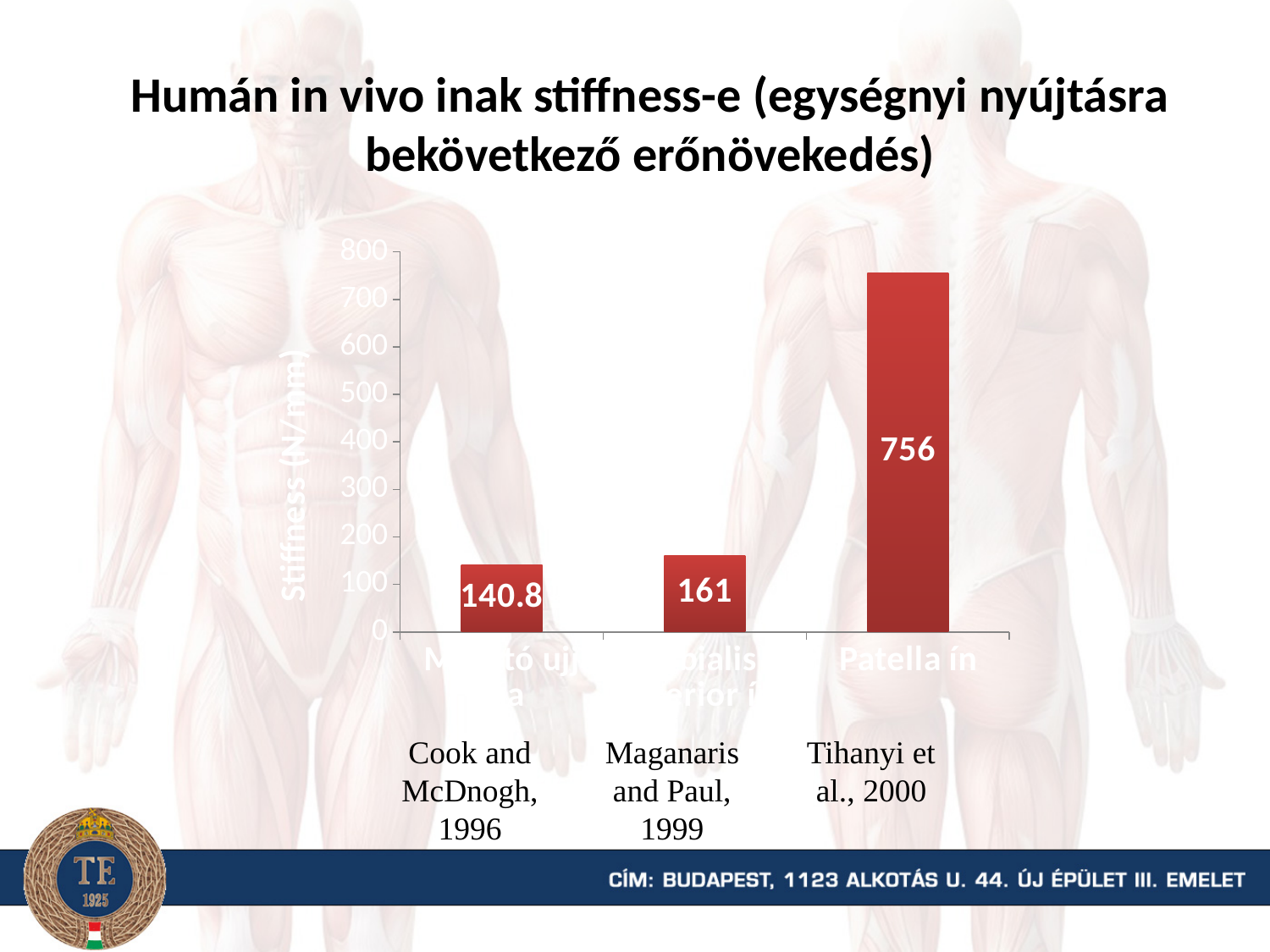
Which citation corresponds to the bar with the lowest value? Cook and McDnogh, 1996 Which bar has the highest value? Patella ín Is the value for Patella ín greater or less than 700? greater What is the value of the bar above the citation 'Maganaris and Paul, 1999'? 161 How many bars are plotted in the chart? 3 What type of chart is shown on the slide? bar chart What is the value of the bar above the citation 'Cook and McDnogh, 1996'? 140.8 What is the maximum value shown on the vertical axis? 800 What is the difference between the Maganaris and Paul, 1999 value and the Cook and McDnogh, 1996 value? 20.2 What is the stiffness value shown for the Patella ín bar? 756 What is the difference between the Patella ín value (756) and the Maganaris and Paul, 1999 value (161)? 595 Which is larger: the bar for Maganaris and Paul, 1999 or the bar for Cook and McDnogh, 1996? Maganaris and Paul, 1999